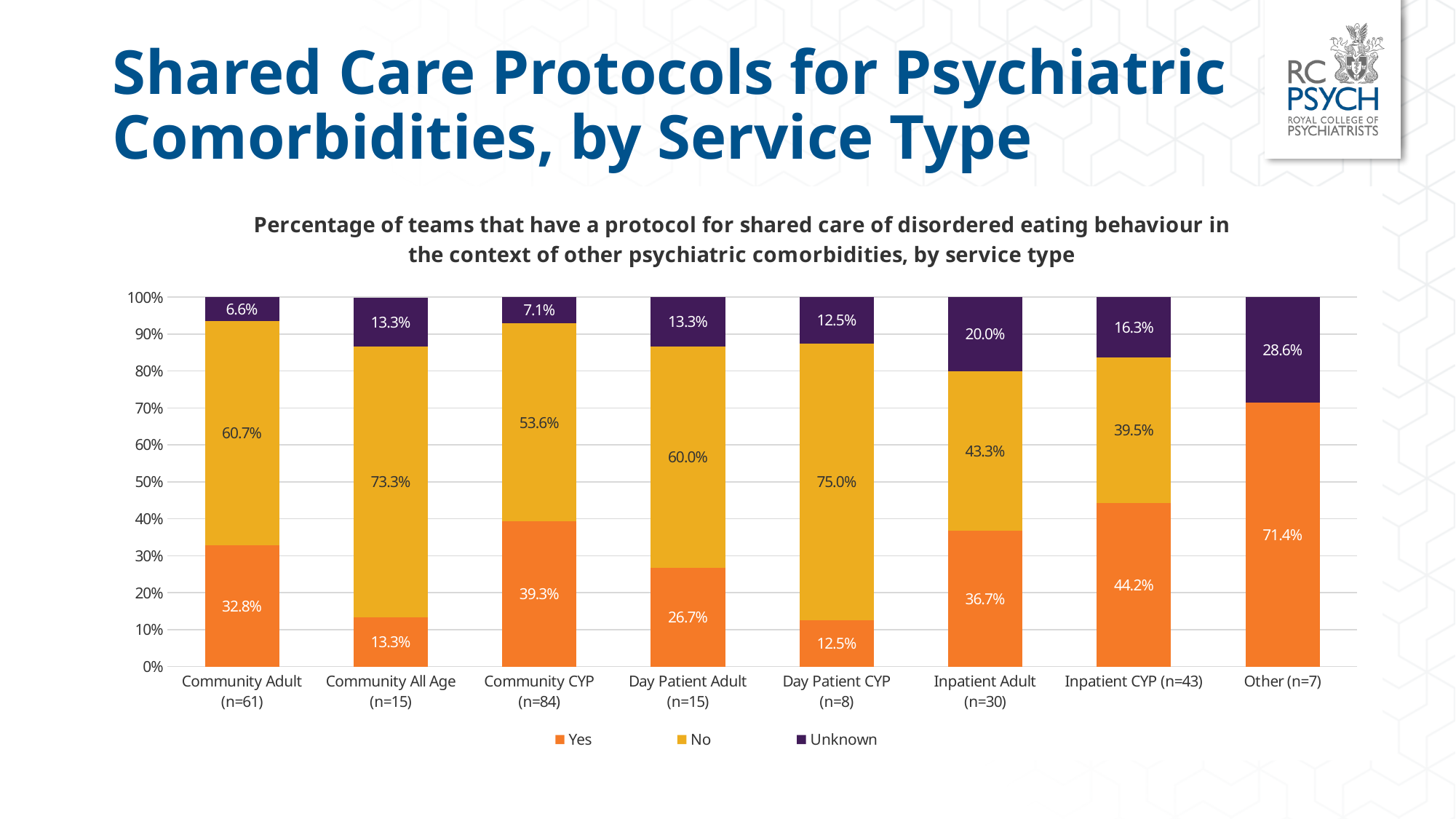
What is the combined Yes and No percentage for Day Patient Adult (n=15)? 86.7% What kind of chart is shown on the slide? Stacked bar chart What is the No percentage for Day Patient CYP (n=8)? 75.0% How many service type categories are shown on the x axis? 8 Which colour represents the Unknown series in the chart? Dark purple How many series does the legend list? 3 Which service type has the lowest Unknown percentage? Community Adult (n=61) What is the Unknown percentage for Inpatient Adult (n=30)? 20.0% What percentage of Community Adult (n=61) teams answered Yes? 32.8% Which has a larger Yes percentage, Inpatient CYP (n=43) or Inpatient Adult (n=30)? Inpatient CYP (n=43) What is the difference between the No percentages for Community All Age (n=15) and Community CYP (n=84)? 19.7% Which service type has the highest Yes percentage? Other (n=7)